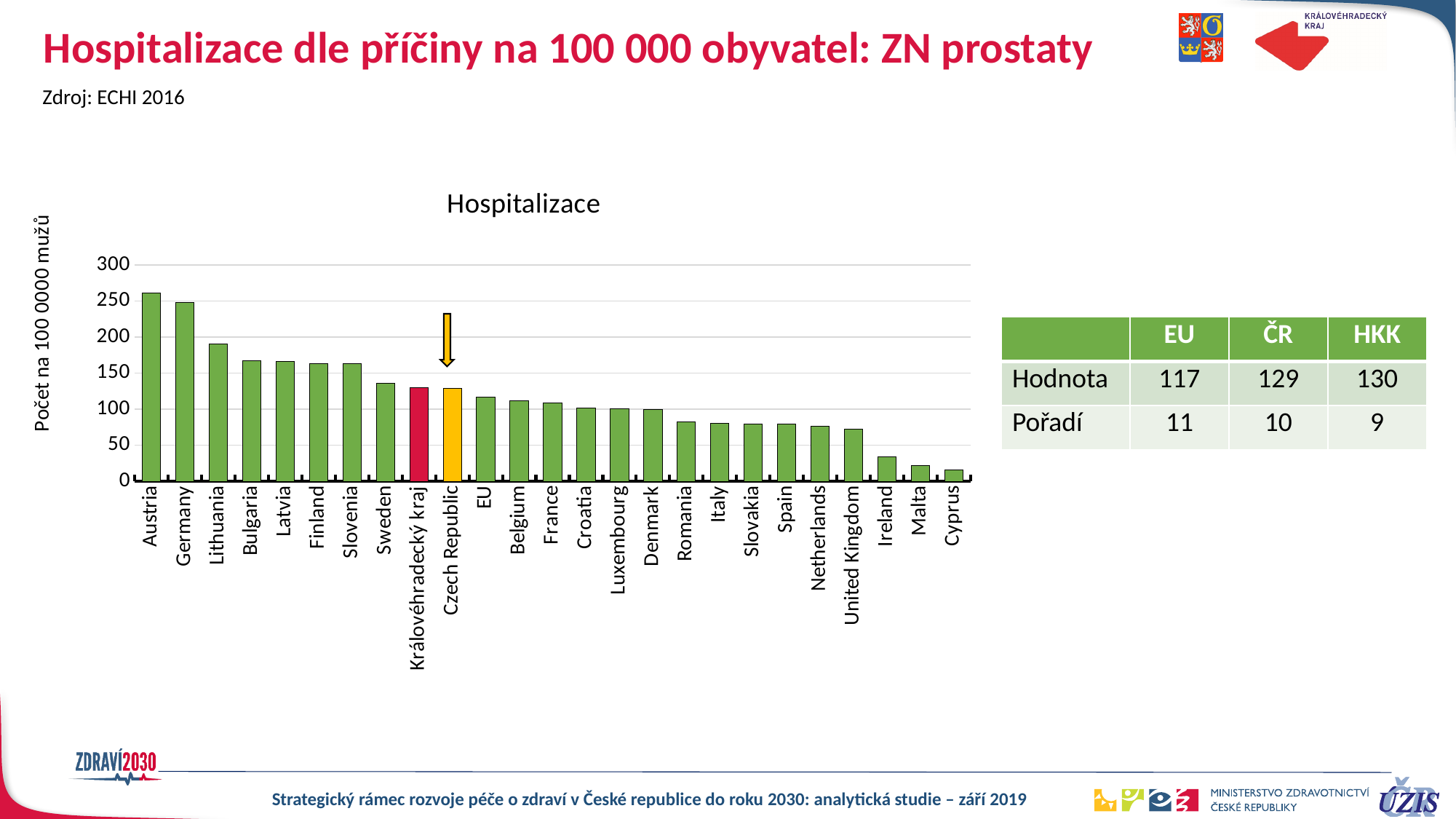
Is the value for Ireland greater or less than 50? less Which category has the lowest value in the chart? Cyprus Do the values rise or fall from left to right along the x axis? fall What is the value for Královéhradecký kraj (HKK) according to the table? 130 What is the title of the chart? Hospitalizace What kind of chart is shown on the slide? bar chart Is the value for Lithuania greater or less than 150? greater How many categories (bars) are plotted in the chart? 25 What is the value for the EU according to the table? 117 What is the difference between the values for ČR and EU shown in the table? 12 Which category has the highest value in the chart? Austria What is the value for the Czech Republic (ČR) according to the table? 129